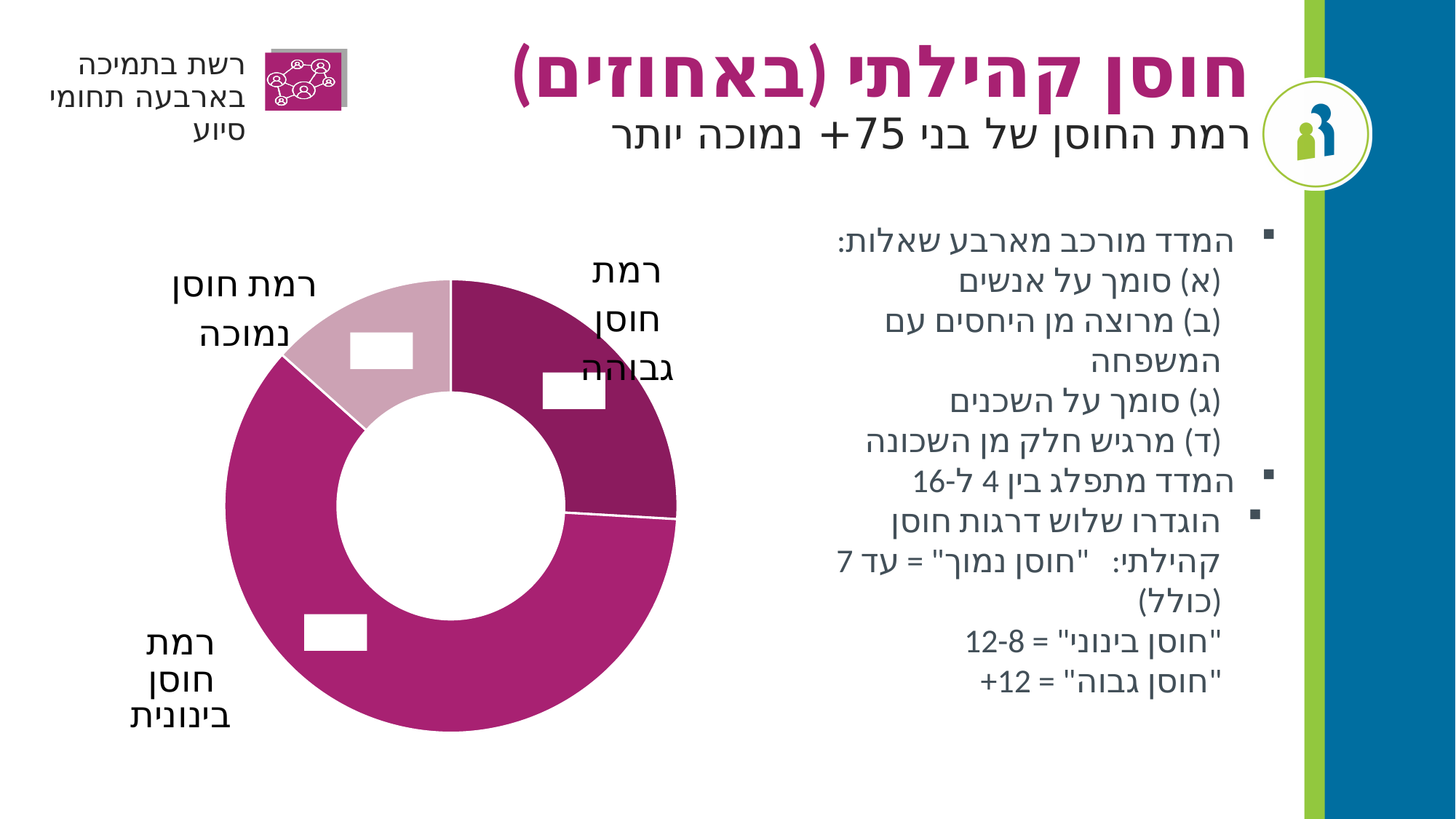
Which slice of the chart is drawn in the lightest colour? רמת חוסן נמוכה Which category has the largest slice in the chart? רמת חוסן בינונית Which category has the smallest slice in the chart? רמת חוסן נמוכה Which slice is larger: רמת חוסן גבוהה or רמת חוסן נמוכה? רמת חוסן גבוהה How many categories (slices) does the chart show? 3 Does the slice for רמת חוסן בינונית cover more or less than half of the chart? more What kind of chart is shown on the slide? Donut (pie) chart Which slice is larger: רמת חוסן בינונית or רמת חוסן גבוהה? רמת חוסן בינונית